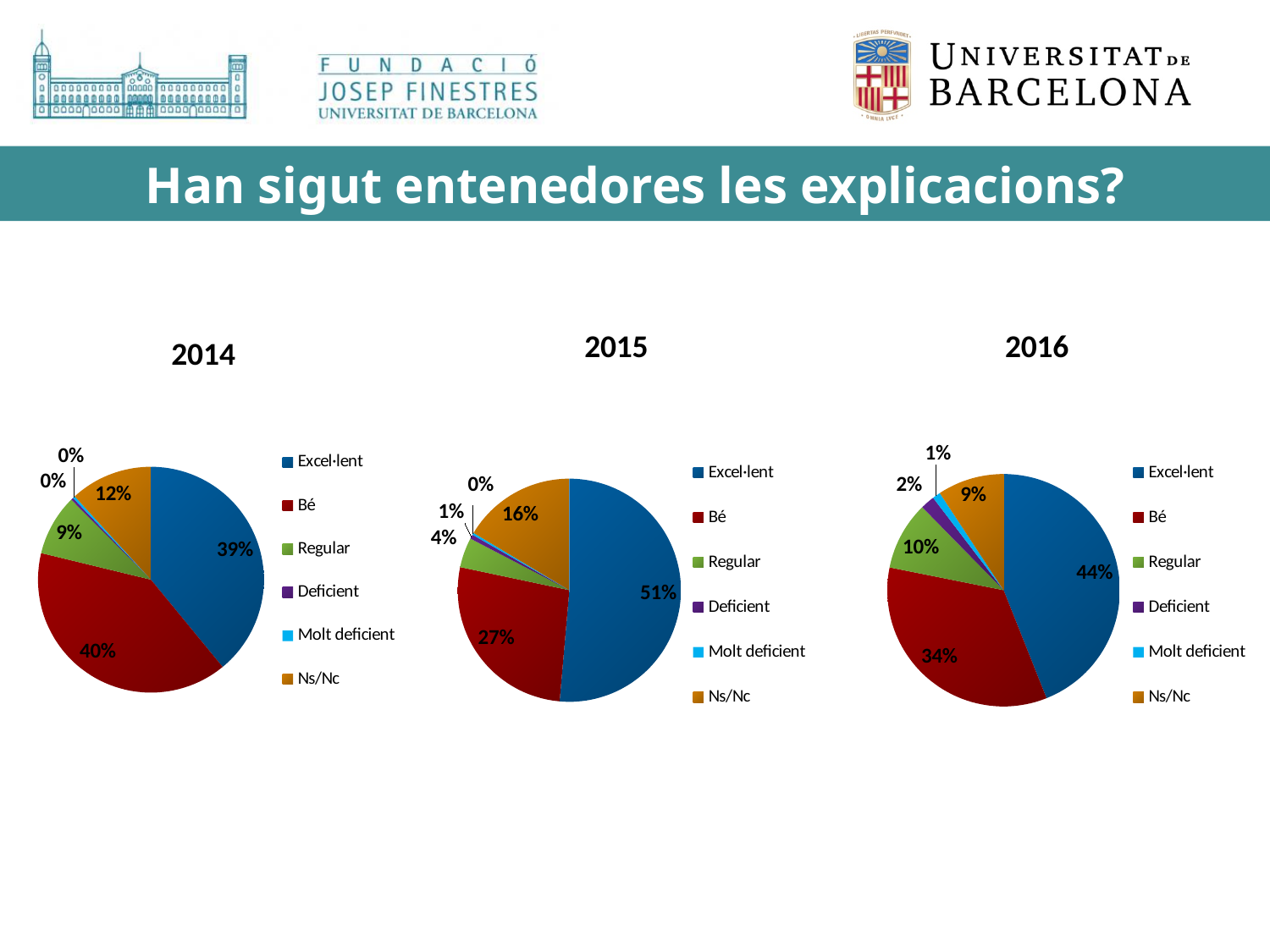
In the 2016 pie chart, what is the difference between the Excel·lent and Bé percentages? 10% In the 2014 pie chart, what percentage is shown for Bé? 40% In the 2015 pie chart, what percentage is shown for Ns/Nc? 16% In the 2015 pie chart, which category has the largest share? Excel·lent What kind of chart is used for the 2016 data? Pie chart In the 2014 pie chart, what percentage is shown for Ns/Nc? 12% In the 2016 pie chart, which category has the largest share? Excel·lent In the 2015 pie chart, what percentage is shown for Excel·lent? 51% What is the title of the slide containing the three pie charts? Han sigut entenedores les explicacions? In the 2016 pie chart, what percentage is shown for Regular? 10% How many categories does the legend of the 2014 chart list? 6 In the 2015 pie chart, which is larger, Regular or Ns/Nc? Ns/Nc